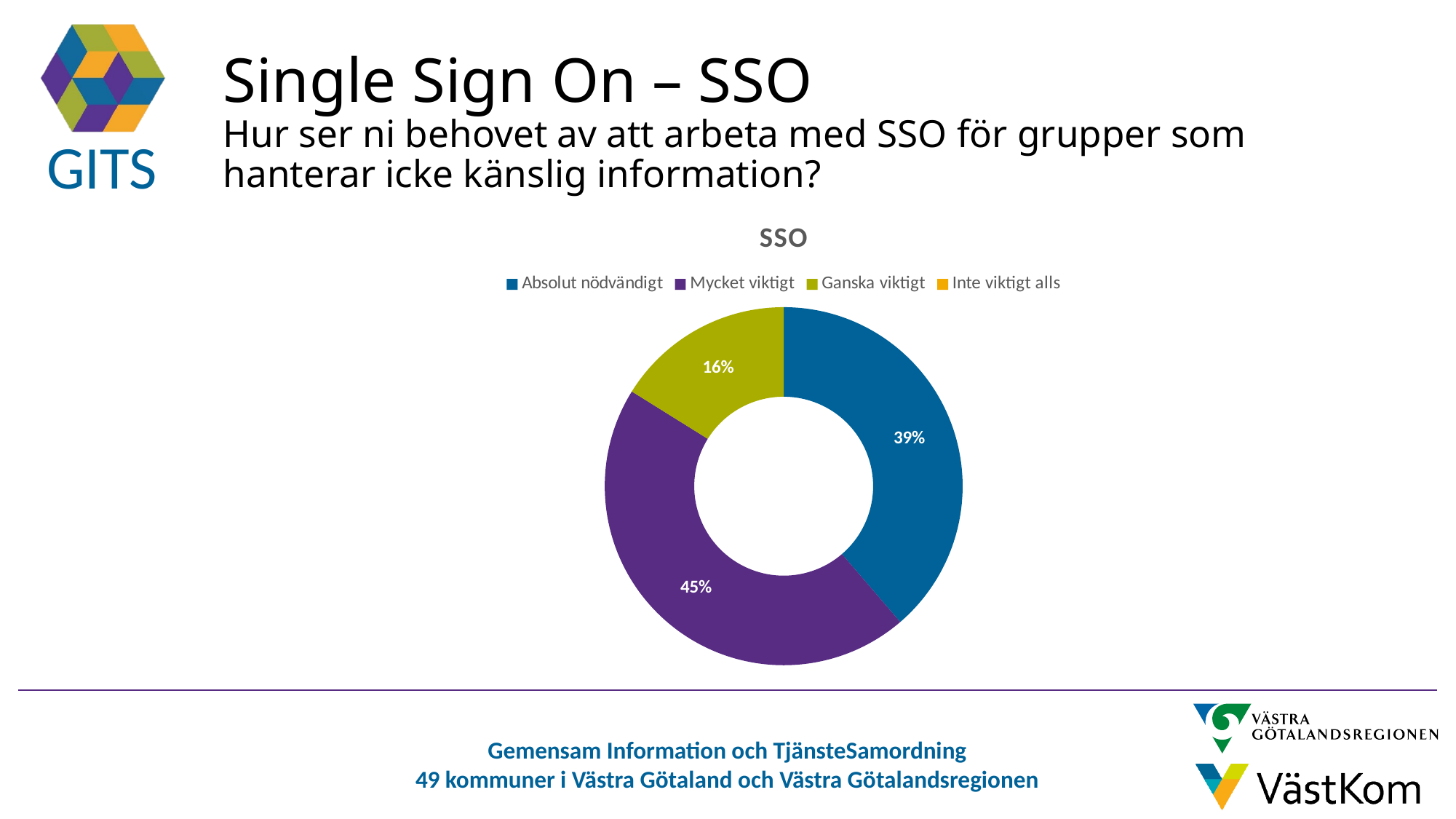
What is the difference in percentage points between the "Mycket viktigt" and "Absolut nödvändigt" slices? 6 percentage points How many categories does the chart legend list? 4 Which colour represents "Ganska viktigt" in the chart? Green What percentage of the pie chart is labelled for "Ganska viktigt"? 16% What percentage of the pie chart is labelled for "Absolut nödvändigt"? 39% Which slice is larger, "Mycket viktigt" or "Ganska viktigt"? Mycket viktigt What percentage of the pie chart is labelled for "Mycket viktigt"? 45% What is the difference in percentage points between the "Absolut nödvändigt" and "Ganska viktigt" slices? 23 percentage points What is the title of the chart? SSO What type of chart is shown on the slide? Pie chart (doughnut) Which category has the largest slice in the pie chart? Mycket viktigt Which slice is larger, "Absolut nödvändigt" or "Ganska viktigt"? Absolut nödvändigt